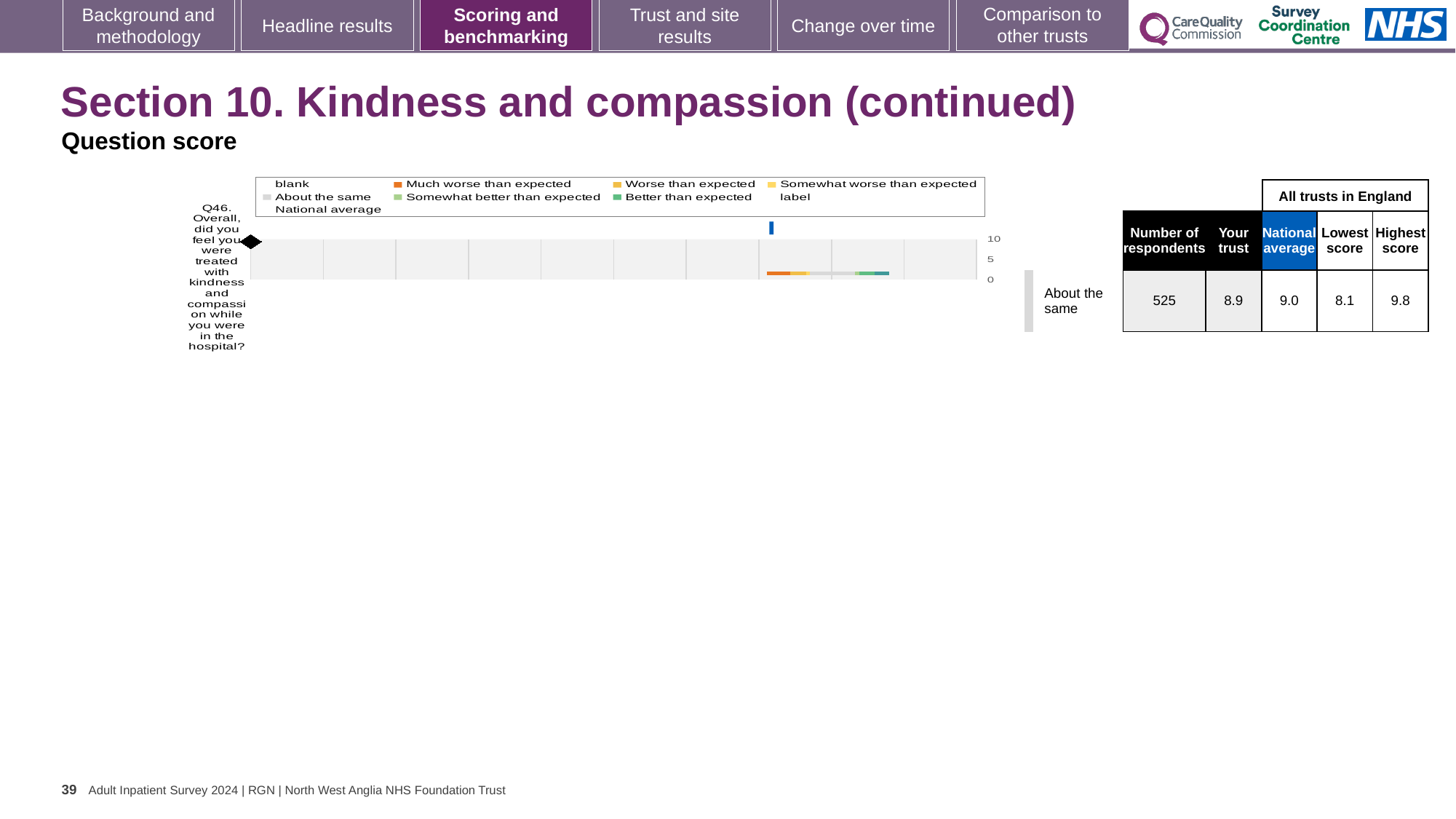
What is the difference between the highest and lowest scores for Q46 across all trusts in England? 1.7 What benchmark category is the trust's Q46 score placed in? About the same What kind of chart is used to show the Q46 question score? bar chart How many entries does the chart legend list? 9 What is the lowest score among all trusts in England for Q46? 8.1 Which is larger for Q46, the 'Your trust' score or the national average? National average What is the highest score among all trusts in England for Q46? 9.8 What colour represents 'Much worse than expected' in the legend? Orange What is the national average score for Q46? 9.0 How many respondents answered Q46? 525 What is the 'Your trust' score for Q46? 8.9 How many questions (categories) are plotted on the chart? 1